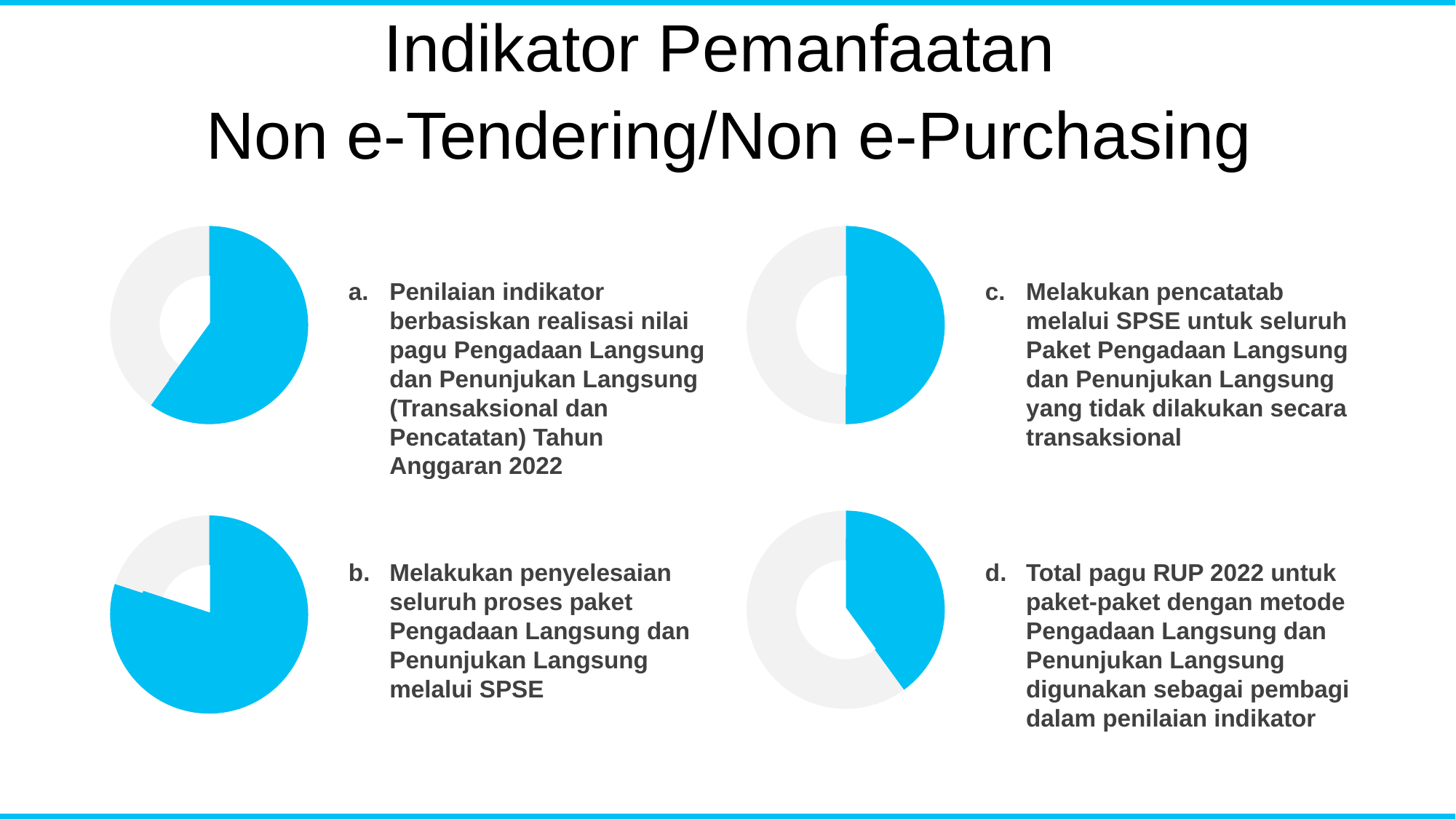
How many segments does the doughnut chart next to item b have? 2 What kind of chart is shown next to item a? doughnut chart How many doughnut charts are on the slide? 4 Is the blue portion of the bottom-right chart (item d) greater or less than half of the doughnut? less What colour is the filled segment in each doughnut chart? blue Which has the larger blue portion, the bottom-left chart (item b) or the top-right chart (item c)? the bottom-left chart (item b) Which of the four doughnut charts has the largest blue portion? the bottom-left chart (item b) Which of the four doughnut charts has the smallest blue portion? the bottom-right chart (item d) Which has the larger blue portion, the top-left chart (item a) or the bottom-right chart (item d)? the top-left chart (item a) Do the doughnut charts show any data labels or legends? No Is the blue portion of the bottom-left chart (item b) greater or less than half of the doughnut? greater